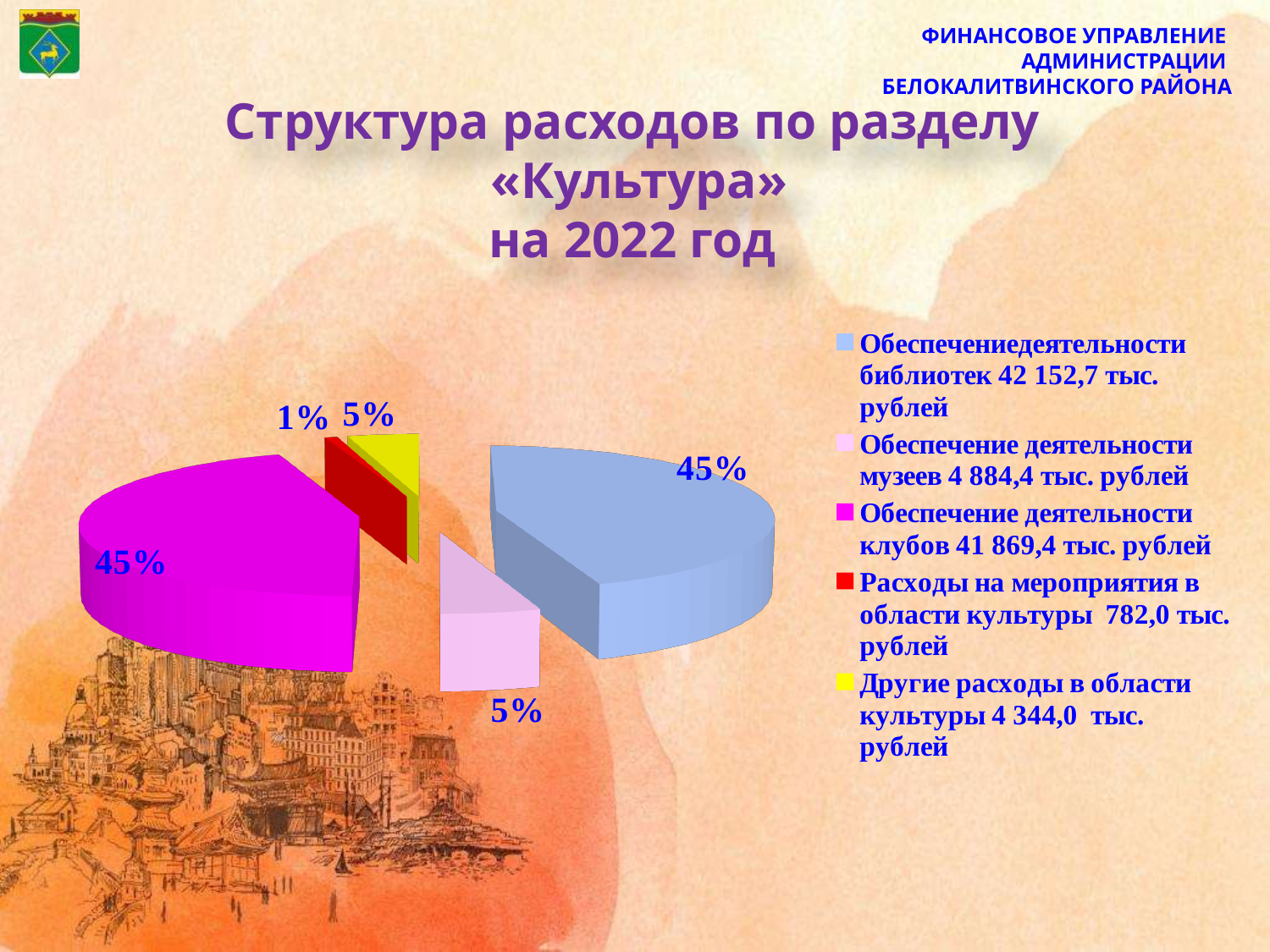
What colour is the slice for «Обеспечение деятельности библиотек»? light blue What is the difference in percentage points between the «Обеспечение деятельности библиотек» slice and the «Другие расходы в области культуры» slice? 40% How many slices does the pie chart have? 5 What share of the pie does «Обеспечение деятельности библиотек» take? 45% Which category has the smallest slice of the pie? Расходы на мероприятия в области культуры Which slice is larger: «Обеспечение деятельности клубов» or «Обеспечение деятельности музеев»? Обеспечение деятельности клубов According to the legend, what amount in thousand rubles is given for «Обеспечение деятельности клубов»? 41 869,4 тыс. рублей What share of the pie does «Расходы на мероприятия в области культуры» take? 1% What share of the pie does «Обеспечение деятельности музеев» take? 5% How many entries does the legend list? 5 What kind of chart is shown on the slide? pie chart